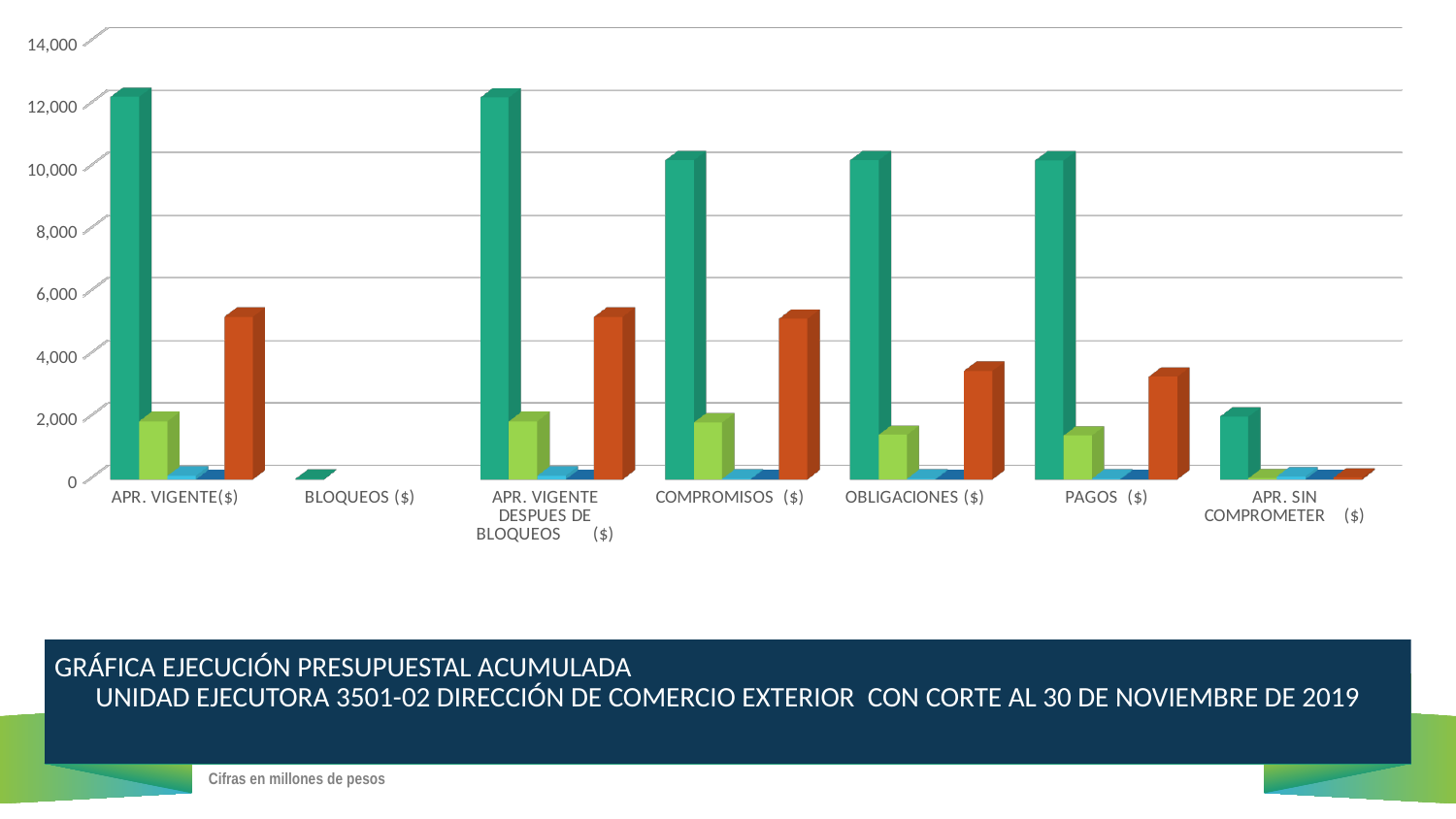
What is the highest value labelled on the vertical axis of the chart? 14,000 Which category has the lowest teal bar? BLOQUEOS ($) Which has the taller orange bar: APR. VIGENTE($) or PAGOS ($)? APR. VIGENTE($) According to the note on the slide, in what units are the chart's figures expressed? millones de pesos Is the value of the teal bar for APR. SIN COMPROMETER ($) greater or less than 4,000? less Is the value of the tallest (teal) bar for APR. VIGENTE($) greater or less than 10,000? greater Is the value of the teal bar for COMPROMISOS ($) greater or less than 8,000? greater How many categories are shown along the x axis of the chart? 7 What kind of chart is shown on the slide? bar chart Which has the taller teal bar: COMPROMISOS ($) or APR. SIN COMPROMETER ($)? COMPROMISOS ($)